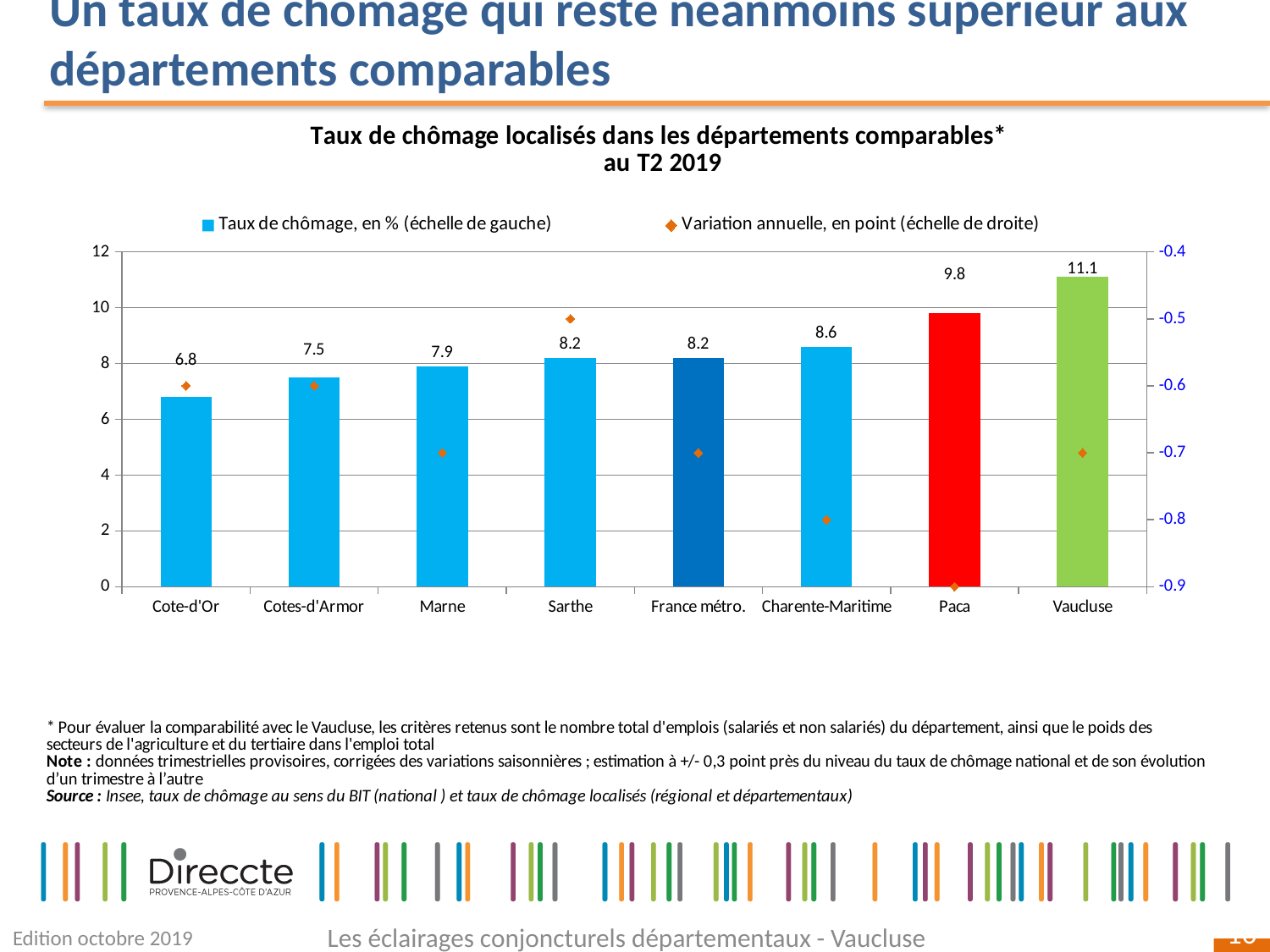
Is the annual variation for Sarthe greater or less than -0.6? greater How many series does the legend list? 2 How many categories are shown on the x axis? 8 Is the annual variation (Variation annuelle) for Charente-Maritime greater or less than -0.7? less What kind of chart is used to show the unemployment rate? Bar chart What is the unemployment rate (Taux de chômage) shown for Vaucluse? 11.1 Which category has the lowest unemployment rate bar? Cote-d'Or What is the difference between the unemployment rates of Vaucluse and Paca? 1.3 What is the unemployment rate shown for Paca? 9.8 Which has a higher unemployment rate, Charente-Maritime or Marne? Charente-Maritime What is the unemployment rate shown for Cote-d'Or? 6.8 Which category has the highest unemployment rate bar? Vaucluse